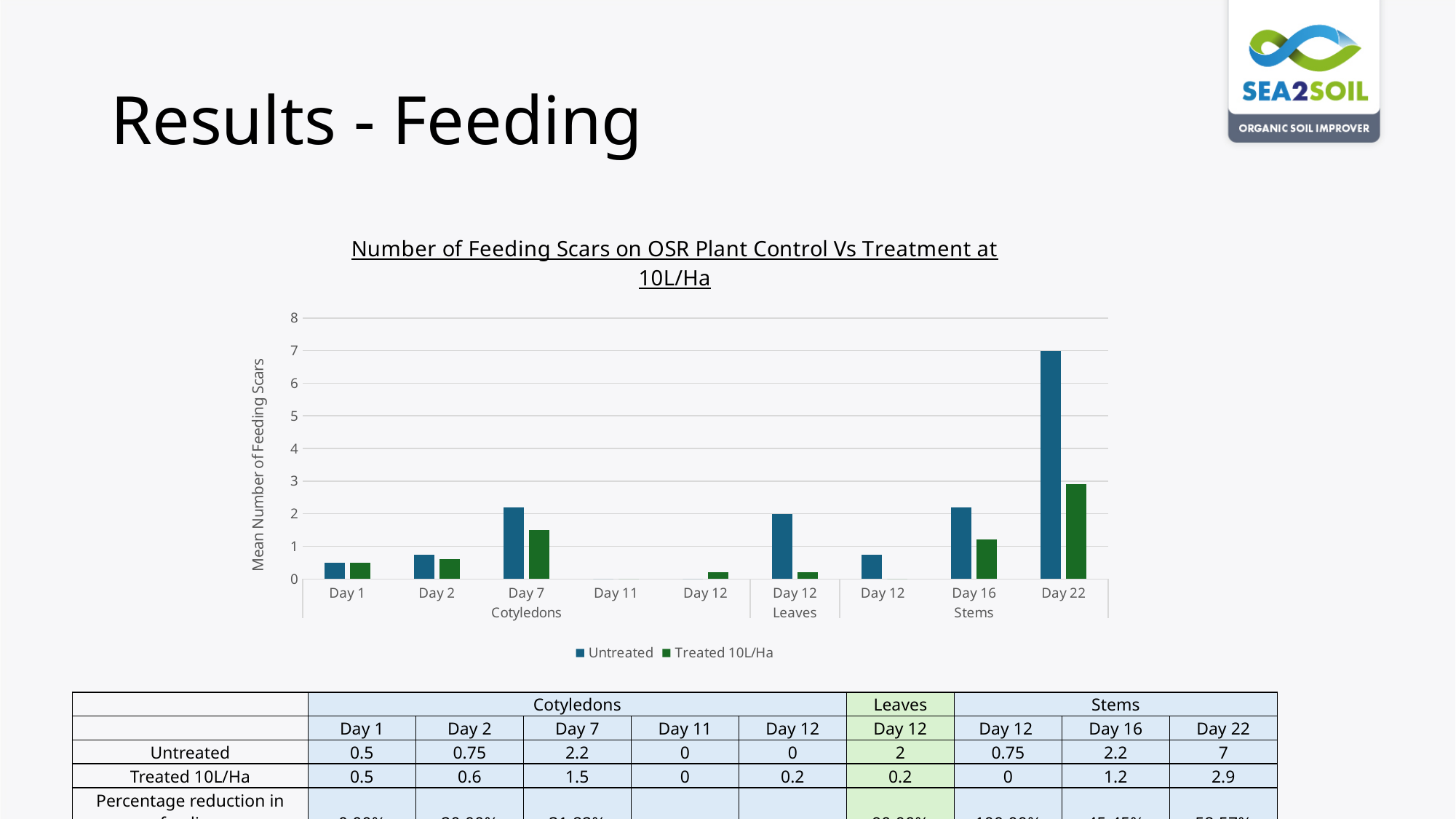
What is the difference between the Untreated and Treated 10L/Ha values for Day 7 (Cotyledons)? 0.7 How many series does the chart legend list? 2 Which category has the highest Untreated value? Day 22 (Stems) Is the Untreated value for Day 22 (Stems) greater or less than 5? greater How many day categories are plotted along the x axis of the chart? 9 For Day 16 (Stems), which series has the larger value, Untreated or Treated 10L/Ha? Untreated What is the Treated 10L/Ha value for Day 7 (Cotyledons)? 1.5 What is the Treated 10L/Ha value for Day 12 (Leaves)? 0.2 What is the Untreated value for Day 22 (Stems)? 7 What is the title of the chart's vertical axis? Mean Number of Feeding Scars What kind of chart is shown on the slide? bar chart What is the difference between the Untreated and Treated 10L/Ha values for Day 22 (Stems)? 4.1